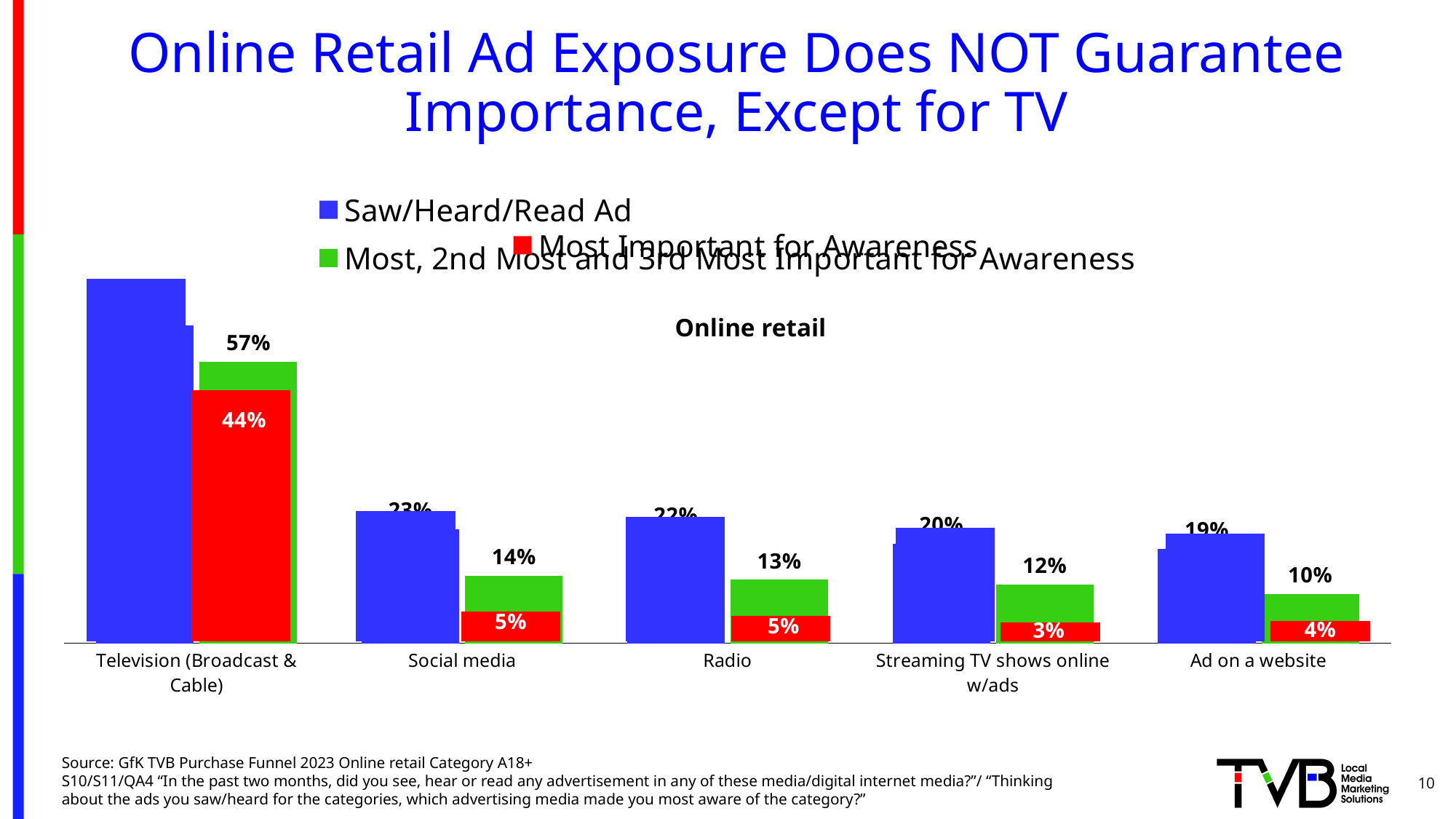
What is the Most Important for Awareness value for Television (Broadcast & Cable)? 44% Which category has the highest Most Important for Awareness value? Television (Broadcast & Cable) How many series does the legend list? 3 For Television (Broadcast & Cable), what is the difference between the Most, 2nd Most and 3rd Most Important for Awareness value and the Most Important for Awareness value? 13% Which has a larger Most, 2nd Most and 3rd Most Important for Awareness value: Radio or Ad on a website? Radio What is the value for Television (Broadcast & Cable) in the Most, 2nd Most and 3rd Most Important for Awareness series? 57% What is the Most Important for Awareness value for Streaming TV shows online w/ads? 3% Which category has the lowest Most Important for Awareness value? Streaming TV shows online w/ads What type of chart is shown on the slide? Bar chart What is the Most, 2nd Most and 3rd Most Important for Awareness value for Social media? 14% What is the Most Important for Awareness value for Ad on a website? 4% How many media categories are shown on the x axis? 5